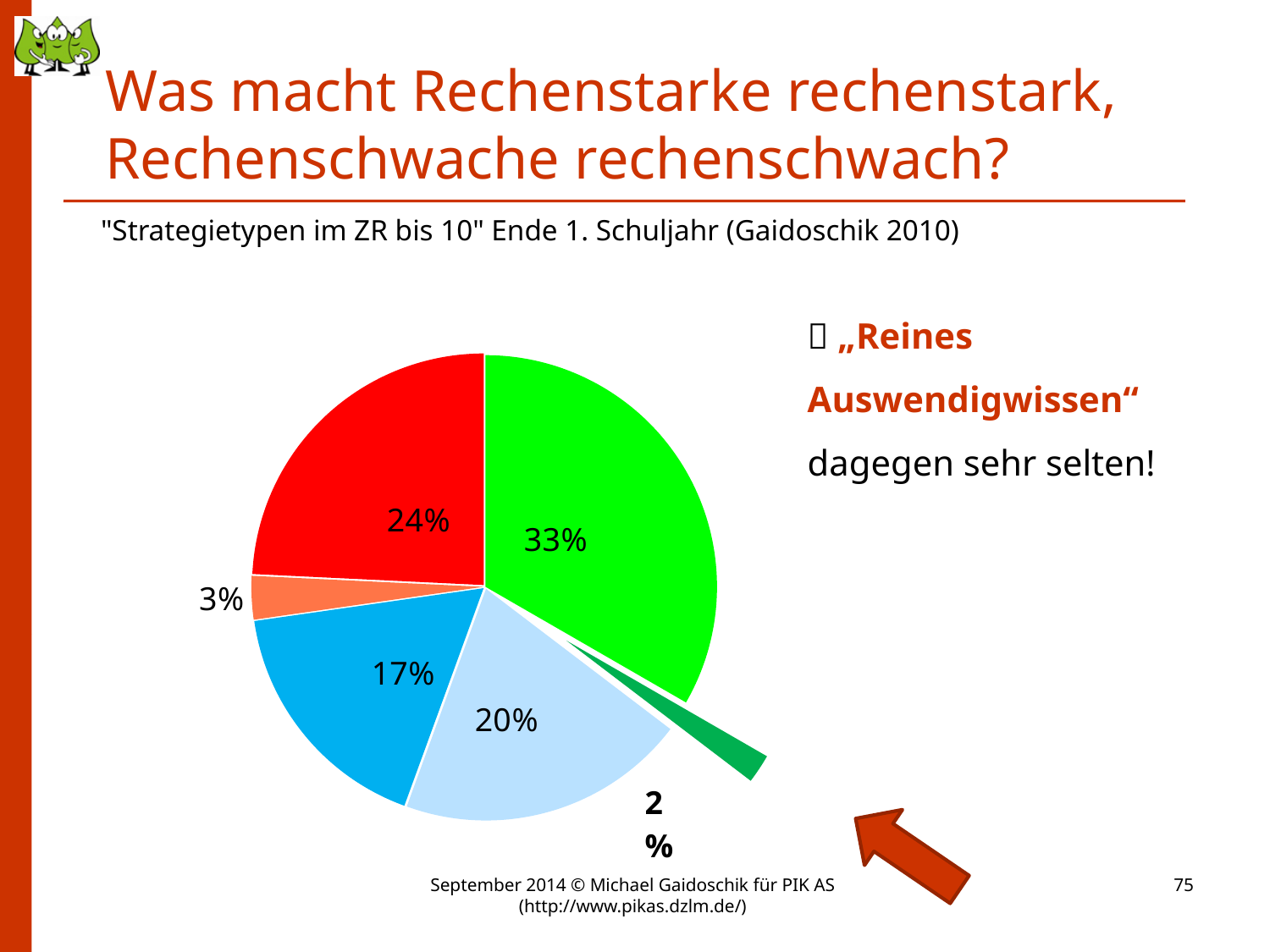
What percentage is shown on the red slice of the pie chart? 24% What kind of chart is shown on the slide? pie chart What percentage is shown on the dark blue slice of the pie chart? 17% Which slice of the pie chart is pulled out (exploded) from the rest of the pie? the dark green 2% slice What percentage is shown on the orange slice of the pie chart? 3% What percentage is shown on the light blue slice of the pie chart? 20% What is the value of the smallest slice of the pie chart? 2% Which slice is larger, the red slice or the light blue slice? the red slice What share of the pie does the exploded dark green slice represent? 2% How many slices does the pie chart have? 6 What is the difference in percentage points between the bright green slice (33%) and the red slice (24%)? 9 What is the value of the largest slice of the pie chart? 33%